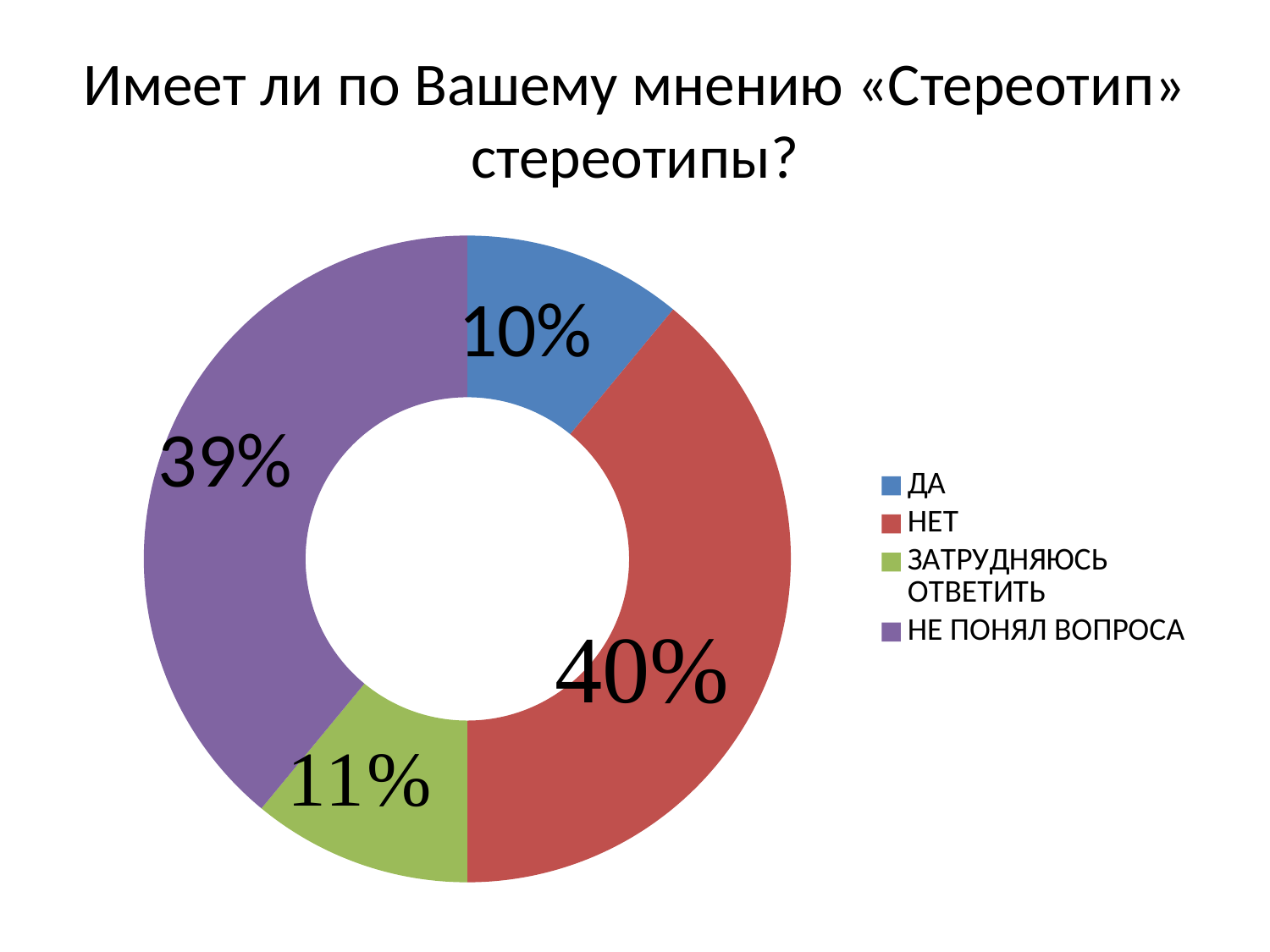
What percentage is shown for НЕ ПОНЯЛ ВОПРОСА? 39% Which answer option has the largest share? НЕТ What is the difference in percentage points between ЗАТРУДНЯЮСЬ ОТВЕТИТЬ and ДА? 1 percentage point How many answer categories does the chart show? 4 What share of respondents answered ДА? 10% What is the difference in percentage points between НЕТ and НЕ ПОНЯЛ ВОПРОСА? 1 percentage point What share of respondents answered НЕТ? 40% What kind of chart is shown on the slide? doughnut chart Which answer option has the smallest share? ДА Which is larger, the share for ДА or the share for ЗАТРУДНЯЮСЬ ОТВЕТИТЬ? ЗАТРУДНЯЮСЬ ОТВЕТИТЬ What colour represents НЕ ПОНЯЛ ВОПРОСА in the chart? purple What percentage is shown for ЗАТРУДНЯЮСЬ ОТВЕТИТЬ? 11%